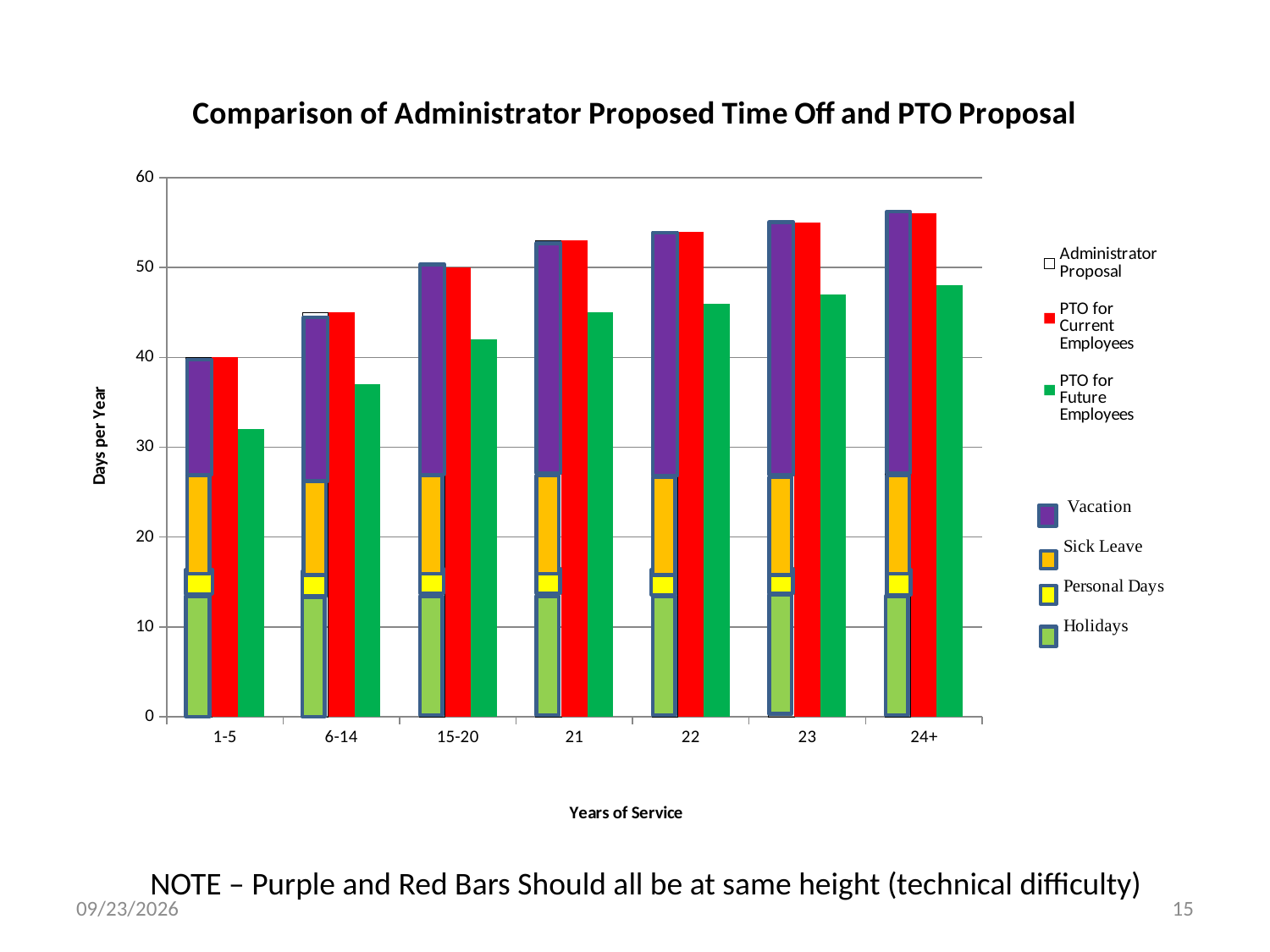
Which years of service category has the lowest value for PTO for Current Employees? 1-5 Is the value of PTO for Current Employees for 24+ years of service greater or less than 50? greater What kind of chart is shown on the slide? bar chart For the 21 years of service category, which is larger: PTO for Current Employees or PTO for Future Employees? PTO for Current Employees How many series does the upper legend list? 3 Do the PTO for Future Employees values rise or fall as years of service increase along the x axis? rise Is the value of PTO for Future Employees for 24+ years of service greater or less than 50? less What is the value of PTO for Current Employees for the 1-5 years of service category? 40 Is the value of PTO for Future Employees for 1-5 years of service greater or less than 30? greater What is the value of PTO for Current Employees for the 15-20 years of service category? 50 Which years of service category has the highest value for PTO for Future Employees? 24+ How many Years of Service categories are shown on the x axis? 7